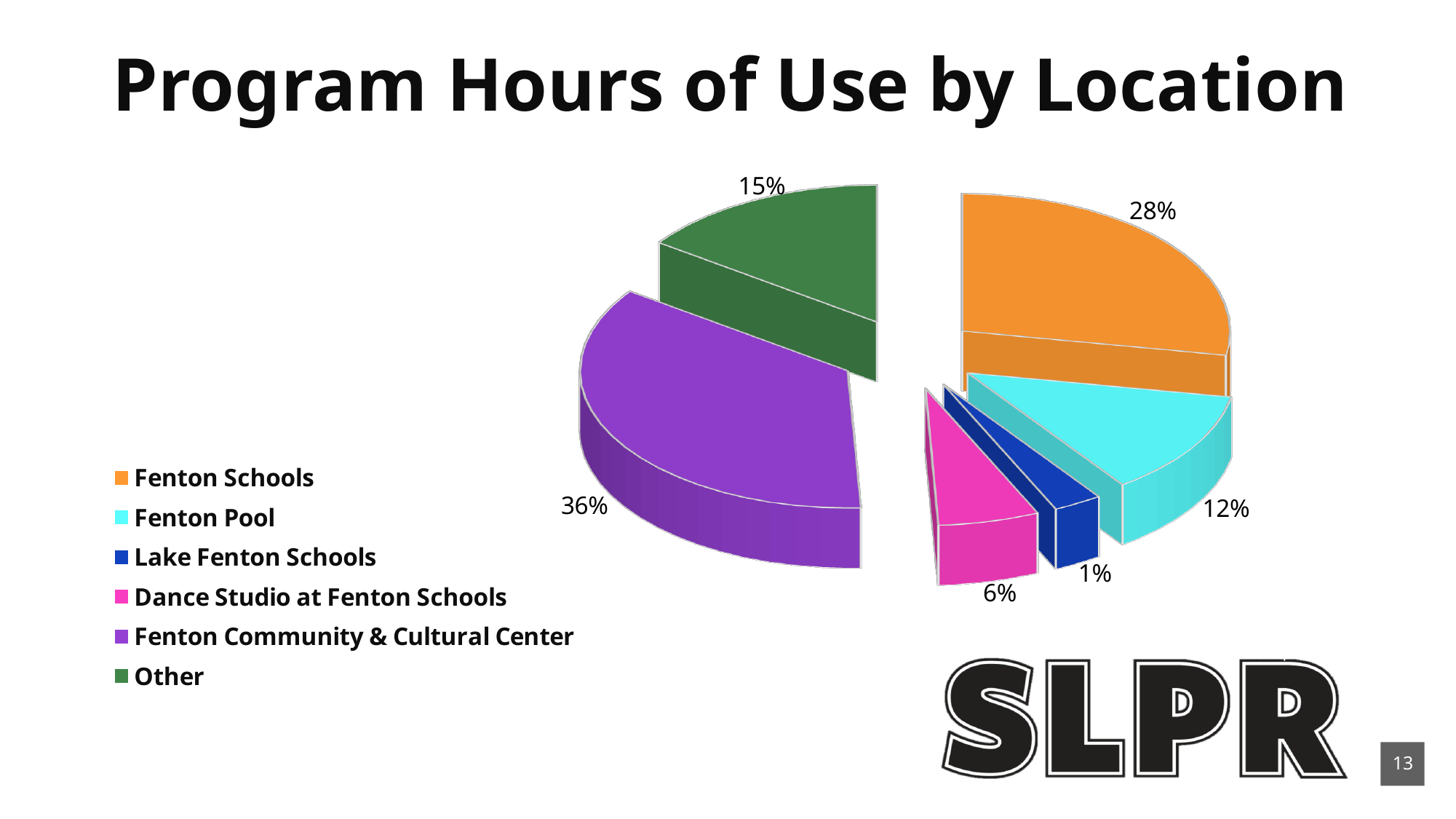
Which has a larger share of program hours: Other or Dance Studio at Fenton Schools? Other What share of program hours of use does Fenton Schools account for? 28% Which location has the smallest share of program hours of use? Lake Fenton Schools What share of program hours of use does Fenton Pool account for? 12% Which location has the largest share of program hours of use? Fenton Community & Cultural Center What share of program hours of use does the Dance Studio at Fenton Schools account for? 6% What type of chart is used on this slide? Pie chart How many locations are shown in the pie chart? 6 What share of program hours of use falls under Other? 15% How many percentage points larger is the Fenton Schools share than the Fenton Pool share? 16 What share of program hours of use does the Fenton Community & Cultural Center account for? 36% What share of program hours of use does Lake Fenton Schools account for? 1%